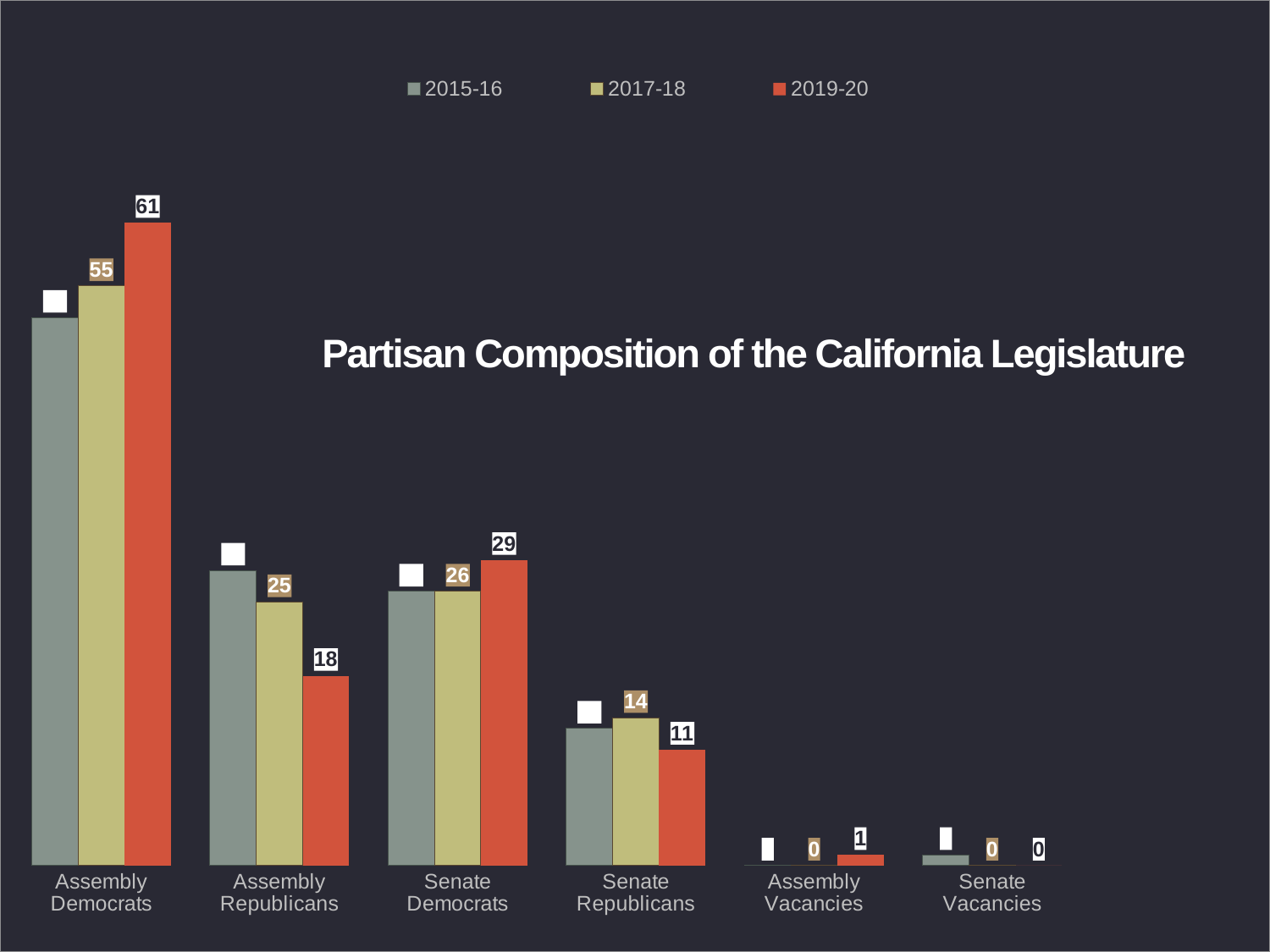
What is the 2017-18 value for Assembly Republicans? 25 Which is larger, the 2019-20 value for Senate Republicans or the 2017-18 value for Senate Republicans? 2017-18 Which category has the highest 2019-20 value? Assembly Democrats How many series does the legend list? 3 What is the 2019-20 value for Senate Democrats? 29 What is the 2019-20 value for Assembly Democrats? 61 What is the 2019-20 value for Assembly Vacancies? 1 How many categories are shown on the x axis? 6 What is the title of the chart? Partisan Composition of the California Legislature What is the difference between the 2017-18 and 2019-20 values for Assembly Republicans? 7 What is the 2017-18 value for Senate Republicans? 14 What is the difference between the 2019-20 and 2017-18 values for Assembly Democrats? 6